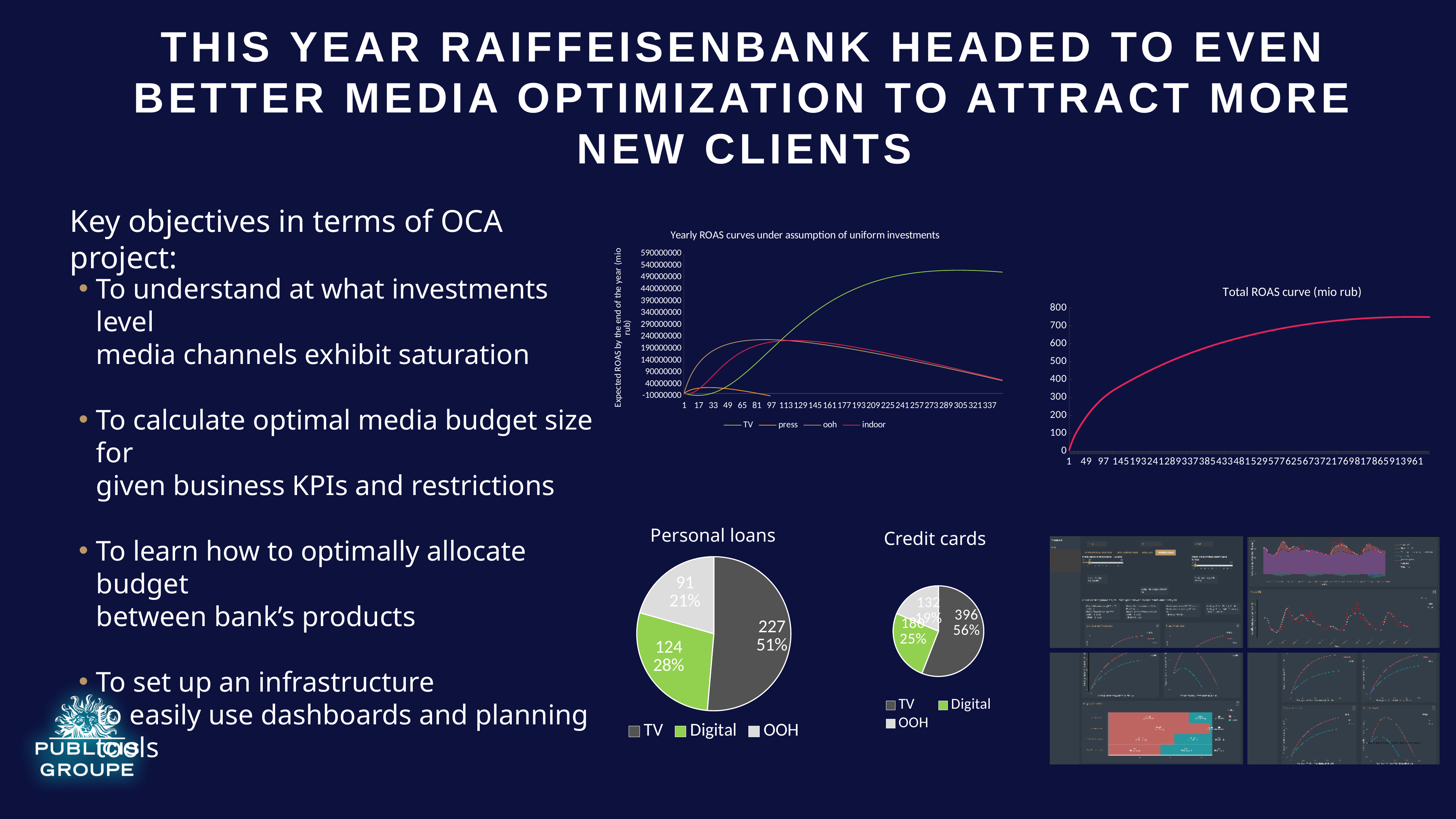
In the Credit cards pie chart, what value is shown for OOH? 132 How many series does the legend of the 'Yearly ROAS curves under assumption of uniform investments' chart list? 4 In the Personal loans pie chart, what share does Digital have? 28% In the 'Yearly ROAS curves under assumption of uniform investments' chart, which series reaches the highest value at the right end of the x axis? TV In the Personal loans pie chart, what value is shown for TV? 227 In the Personal loans pie chart, what share does OOH have? 21% In the Credit cards pie chart, what share does TV have? 56% In the Personal loans pie chart, which category has the smallest slice? OOH What kind of chart is the 'Total ROAS curve (mio rub)' chart? line chart In the Personal loans pie chart, what is the difference between the TV value and the Digital value? 103 In the Credit cards pie chart, what is the difference between the Digital value and the OOH value? 48 In the Credit cards pie chart, what value is shown for TV? 396